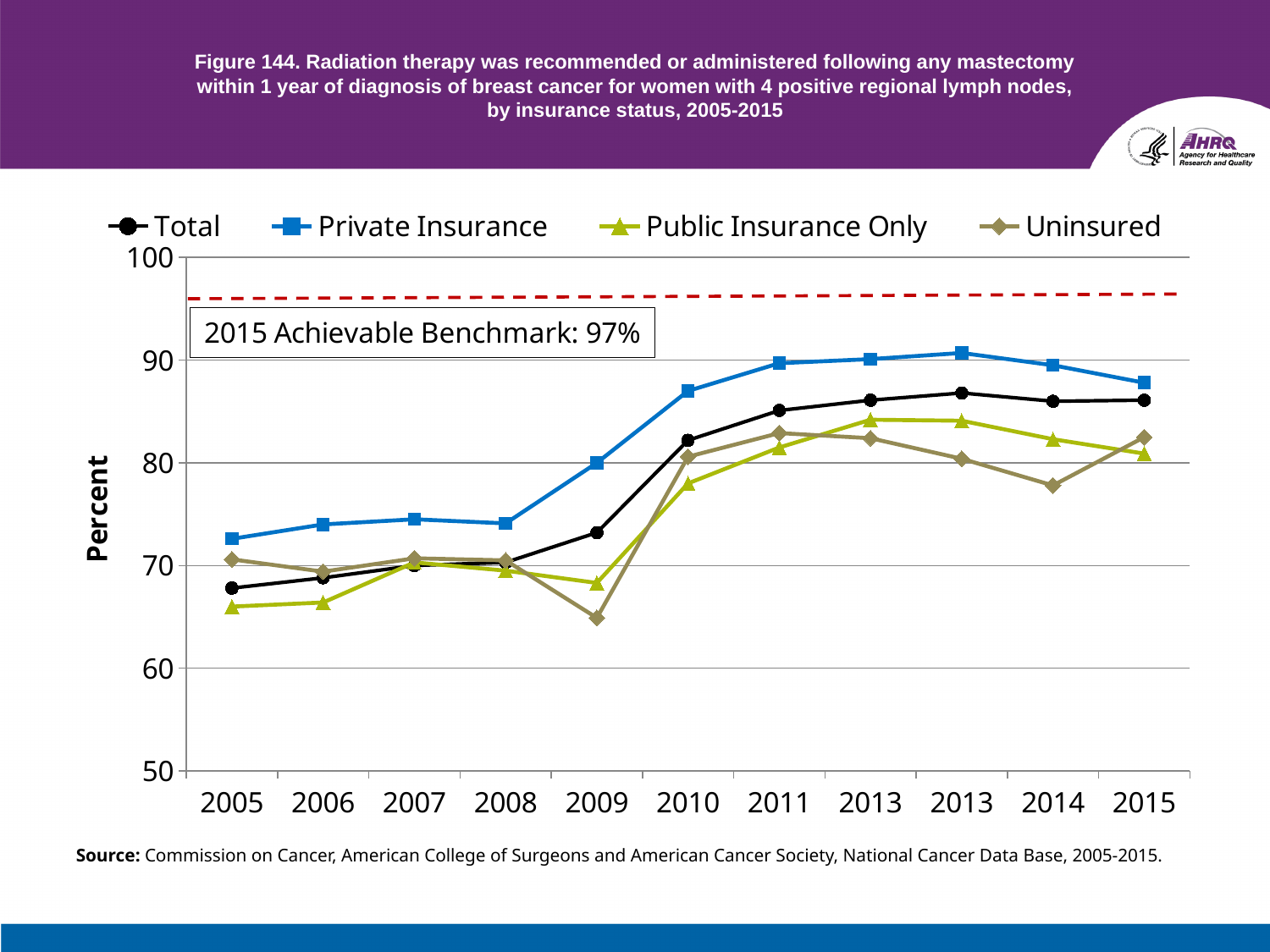
Is the value for Total in 2015 greater or less than 80? greater Which series has the lowest value in 2009? Uninsured What is the 2015 Achievable Benchmark shown on the chart? 97% How many year points are shown along the x axis? 11 How many series does the legend list? 4 Is the value for Public Insurance Only in 2005 greater or less than 70? less Which series has the highest value in 2015? Private Insurance Is the value for Uninsured in 2009 greater or less than 70? less In 2014, which is higher: Public Insurance Only or Uninsured? Public Insurance Only What is the label of the y axis? Percent What kind of chart is shown on the slide? line chart